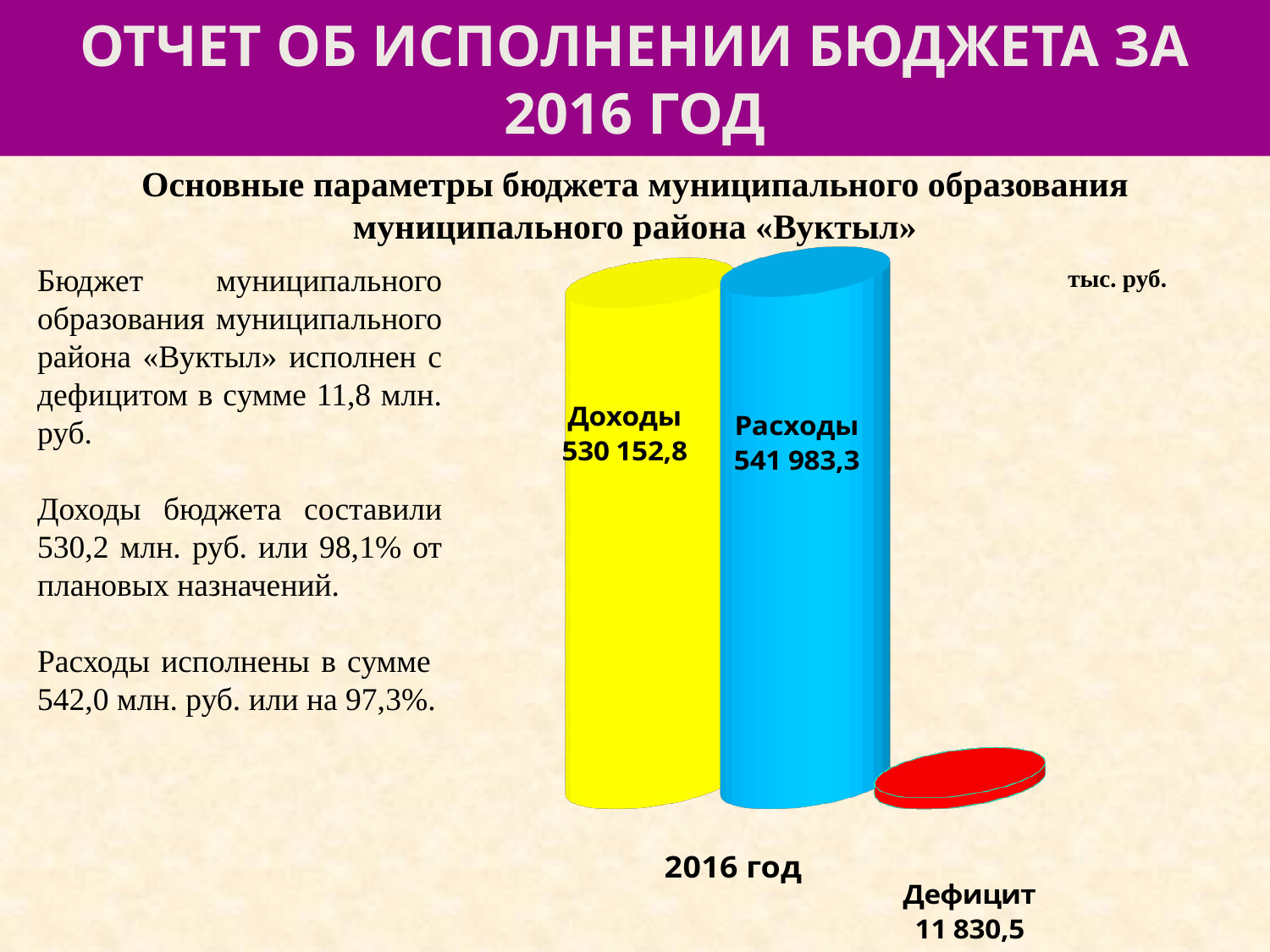
Which of the three plotted values is the lowest? Дефицит How many bars are plotted on the chart? 3 What is the difference between Расходы and Доходы? 11 830,5 In what units are the chart values given, according to the label on the slide? тыс. руб. Which of the three plotted values is the highest? Расходы What is the value shown for Расходы on the chart? 541 983,3 Which year does the chart's category axis label refer to? 2016 год What is the value shown for Дефицит on the chart? 11 830,5 What kind of chart is shown on the slide? Bar chart Which is larger, Доходы or Расходы? Расходы What is the value shown for Доходы on the chart? 530 152,8